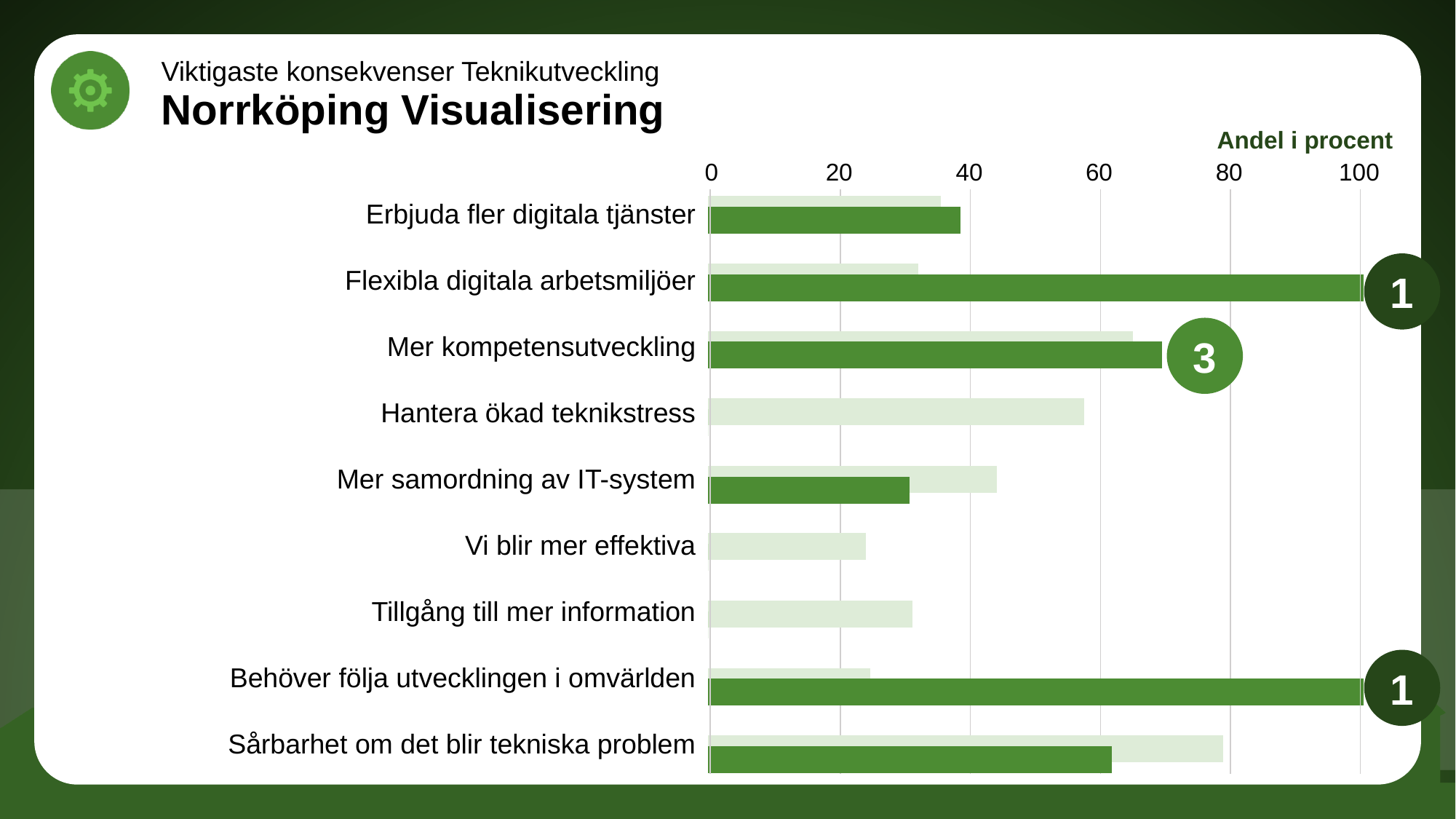
Which has the longer light green bar: Hantera ökad teknikstress or Mer samordning av IT-system? Hantera ökad teknikstress Is the light green bar for Mer samordning av IT-system greater or less than 40? greater What label is shown above the horizontal axis of the chart? Andel i procent What is the main title of the slide above the chart? Norrköping Visualisering How many categories are plotted on the chart? 9 Is the light green bar for Vi blir mer effektiva greater or less than 20? greater What is the value of the dark green bar for Flexibla digitala arbetsmiljöer? 100 Which category has the longest light green bar? Sårbarhet om det blir tekniska problem Is the dark green bar for Mer kompetensutveckling greater or less than 60? greater What is the value of the dark green bar for Behöver följa utvecklingen i omvärlden? 100 What kind of chart is shown on the slide? bar chart